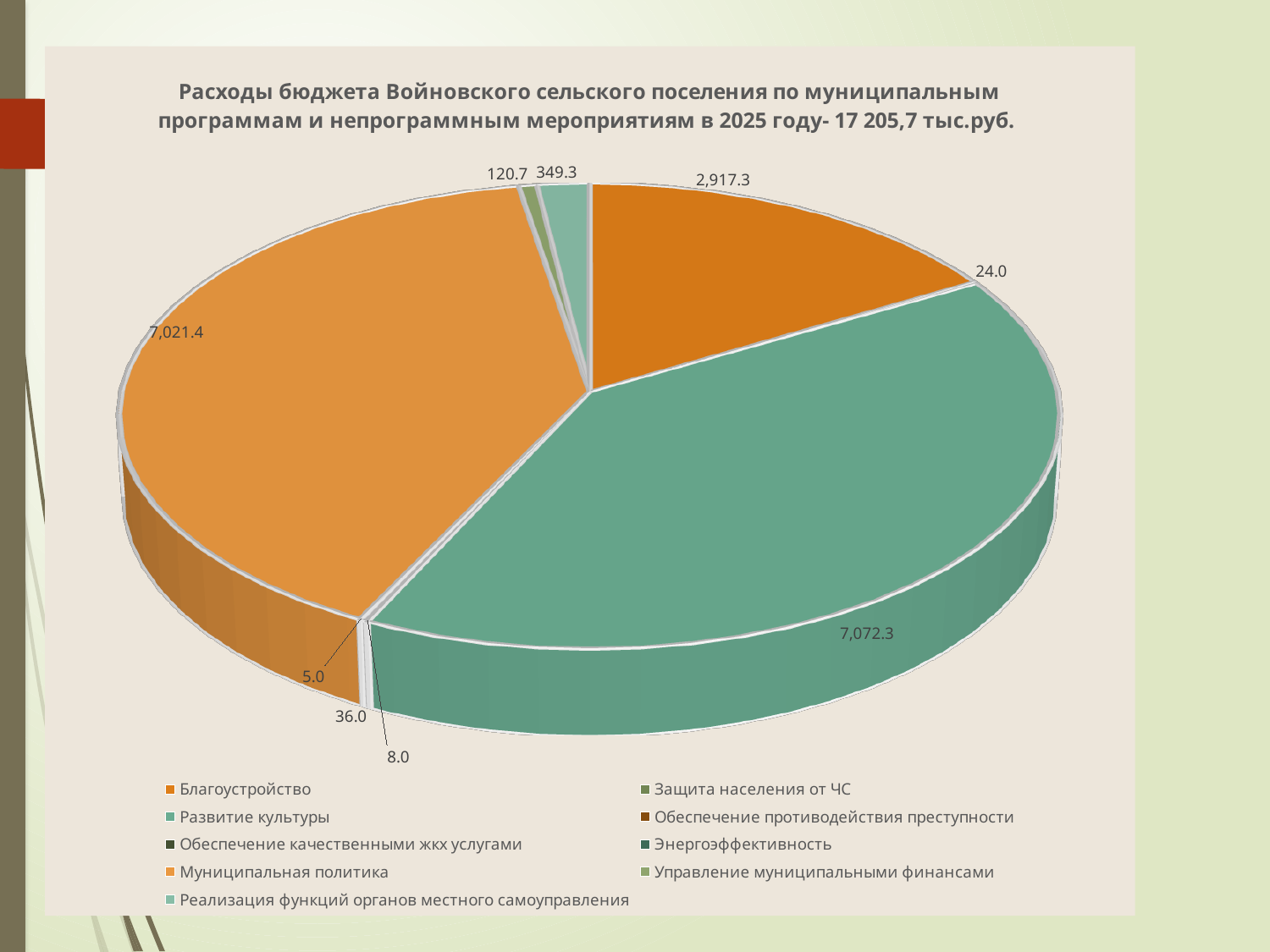
What is the difference between the values for Развитие культуры and Муниципальная политика? 50.9 How many categories does the legend list? 9 What is the value shown for Развитие культуры? 7,072.3 Which is larger, the value for Благоустройство or the value for Реализация функций органов местного самоуправления? Благоустройство What is the value shown for Муниципальная политика? 7,021.4 What is the value shown for Управление муниципальными финансами? 120.7 What kind of chart is shown on the slide? pie chart What is the value shown for Реализация функций органов местного самоуправления? 349.3 Which category has the largest slice of the pie? Развитие культуры According to the chart title, what is the total budget expenditure for 2025? 17 205,7 тыс.руб. What is the value shown for Благоустройство? 2,917.3 What is the smallest value labelled on the pie? 5.0